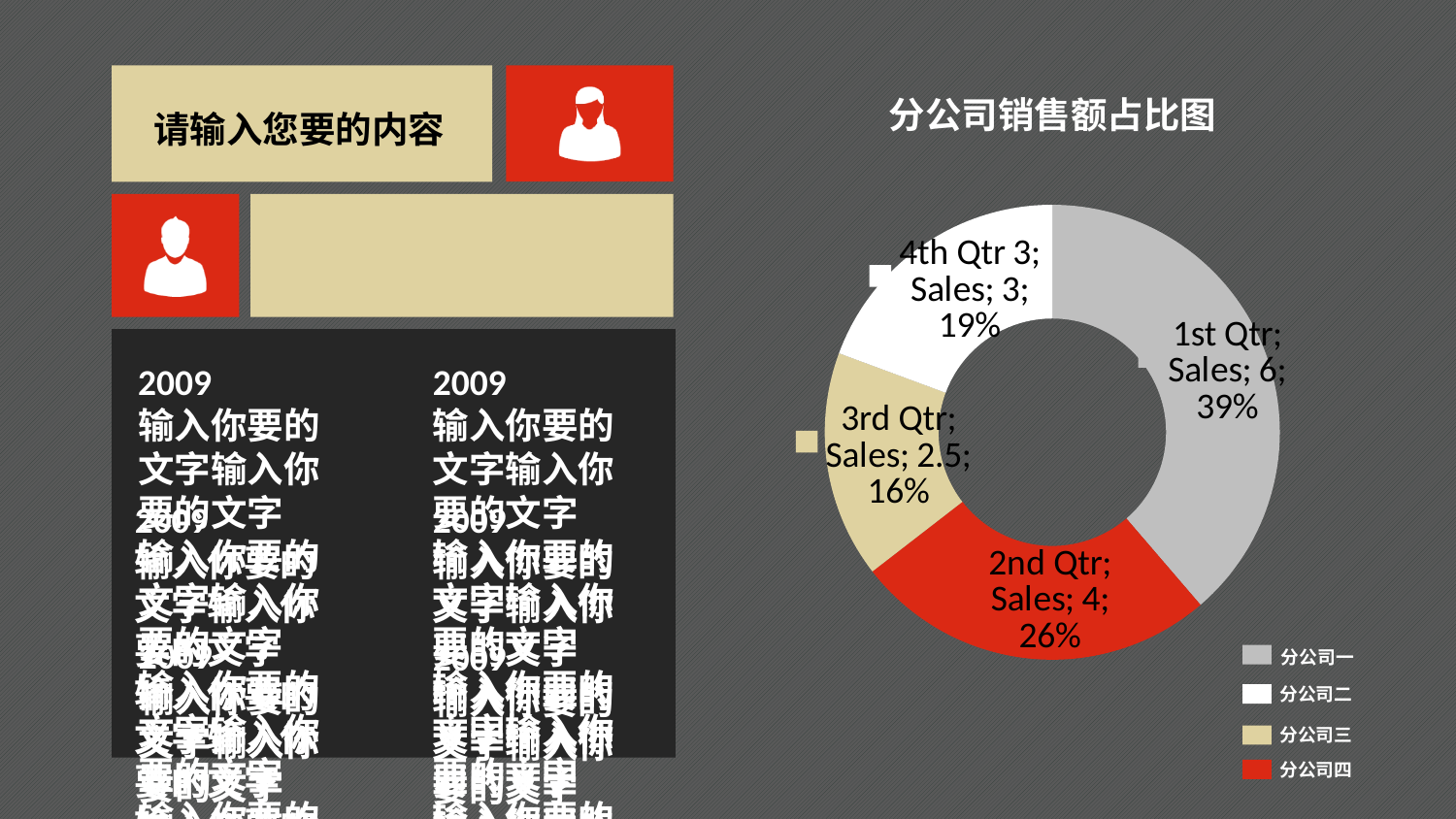
Which quarter has the lowest Sales value? 3rd Qtr What is the Sales value for 2nd Qtr? 4 What percentage share does 1st Qtr have? 39% What kind of chart is shown on the slide? doughnut chart What percentage share does 4th Qtr have? 19% What is the Sales value for 3rd Qtr? 2.5 What is the difference between the Sales values for 1st Qtr and 2nd Qtr? 2 What is the title of the chart on the slide? 分公司销售额占比图 What is the Sales value for 1st Qtr? 6 Which quarter has the highest Sales value? 1st Qtr Which is larger, the Sales value for 2nd Qtr or for 4th Qtr? 2nd Qtr How many slices does the doughnut chart have? 4